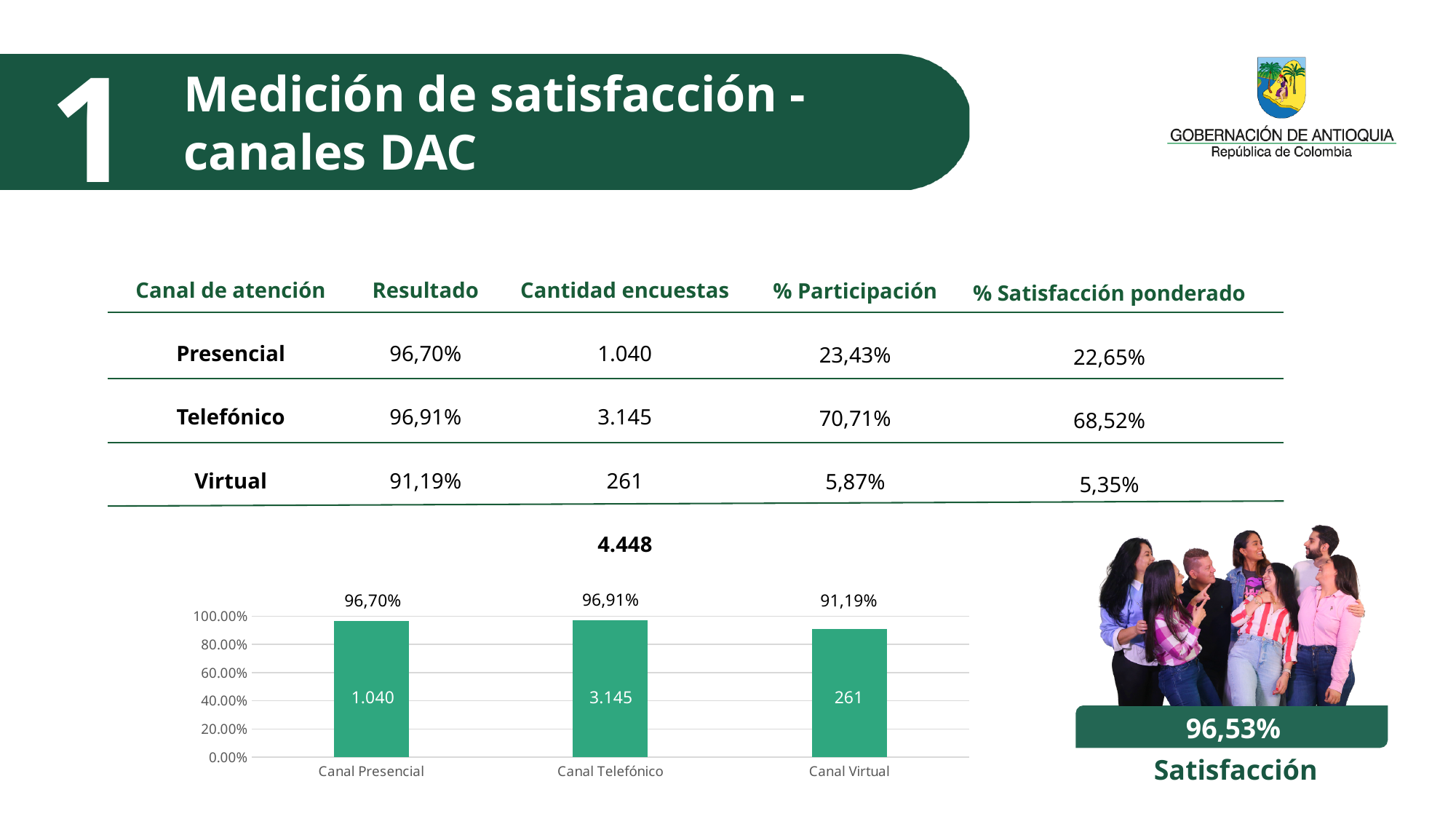
Which category has the highest satisfaction value in the bar chart? Canal Telefónico Which category has the lowest satisfaction value in the bar chart? Canal Virtual What is the satisfaction value shown above the bar for Canal Virtual? 91,19% Is the value for Canal Virtual greater or less than 80.00%? greater What is the highest tick value shown on the y axis of the bar chart? 100.00% What number is printed inside the bar for Canal Telefónico? 3.145 How many categories are plotted in the bar chart? 3 What is the satisfaction value shown above the bar for Canal Telefónico? 96,91% What number is printed inside the bar for Canal Virtual? 261 What type of chart is shown on the slide? bar chart Which has a higher satisfaction value, Canal Presencial or Canal Virtual? Canal Presencial What is the satisfaction value shown above the bar for Canal Presencial? 96,70%